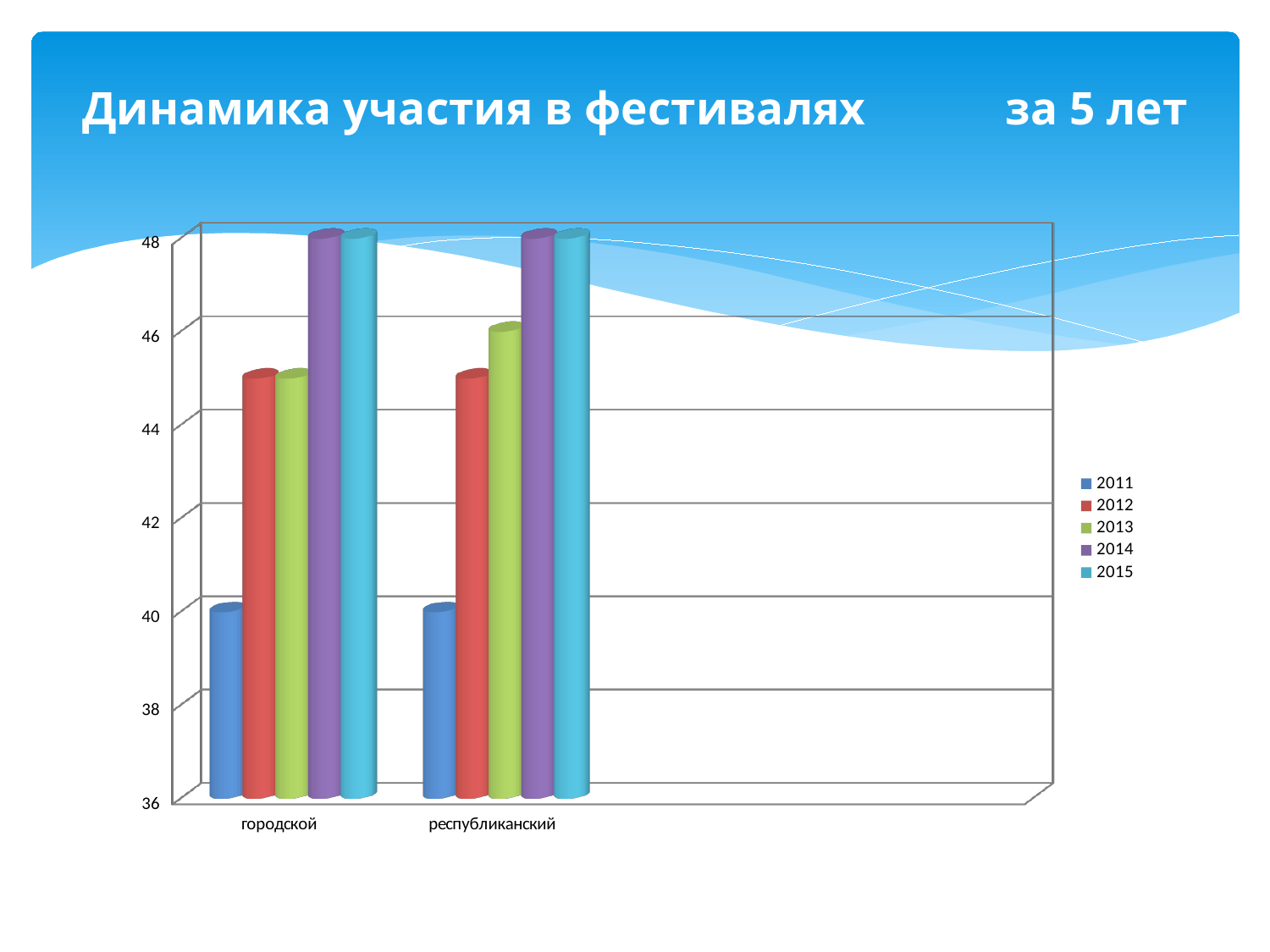
Which is larger in the республиканский category: the value for 2013 or the value for 2014? 2014 What is the value for 2014 in the республиканский category? 48 What is the value for 2011 in the городской category? 40 What kind of chart is shown on the slide? bar chart Is the value for 2012 in the республиканский category greater or less than 46? less Which year is shown in purple in the legend? 2014 How many series does the legend list? 5 What is the value for 2013 in the республиканский category? 46 Is the value for 2012 in the городской category greater or less than 44? greater How many categories are shown on the x axis? 2 Which year has the lowest value in the городской category? 2011 What is the difference between the 2015 value and the 2011 value in the республиканский category? 8